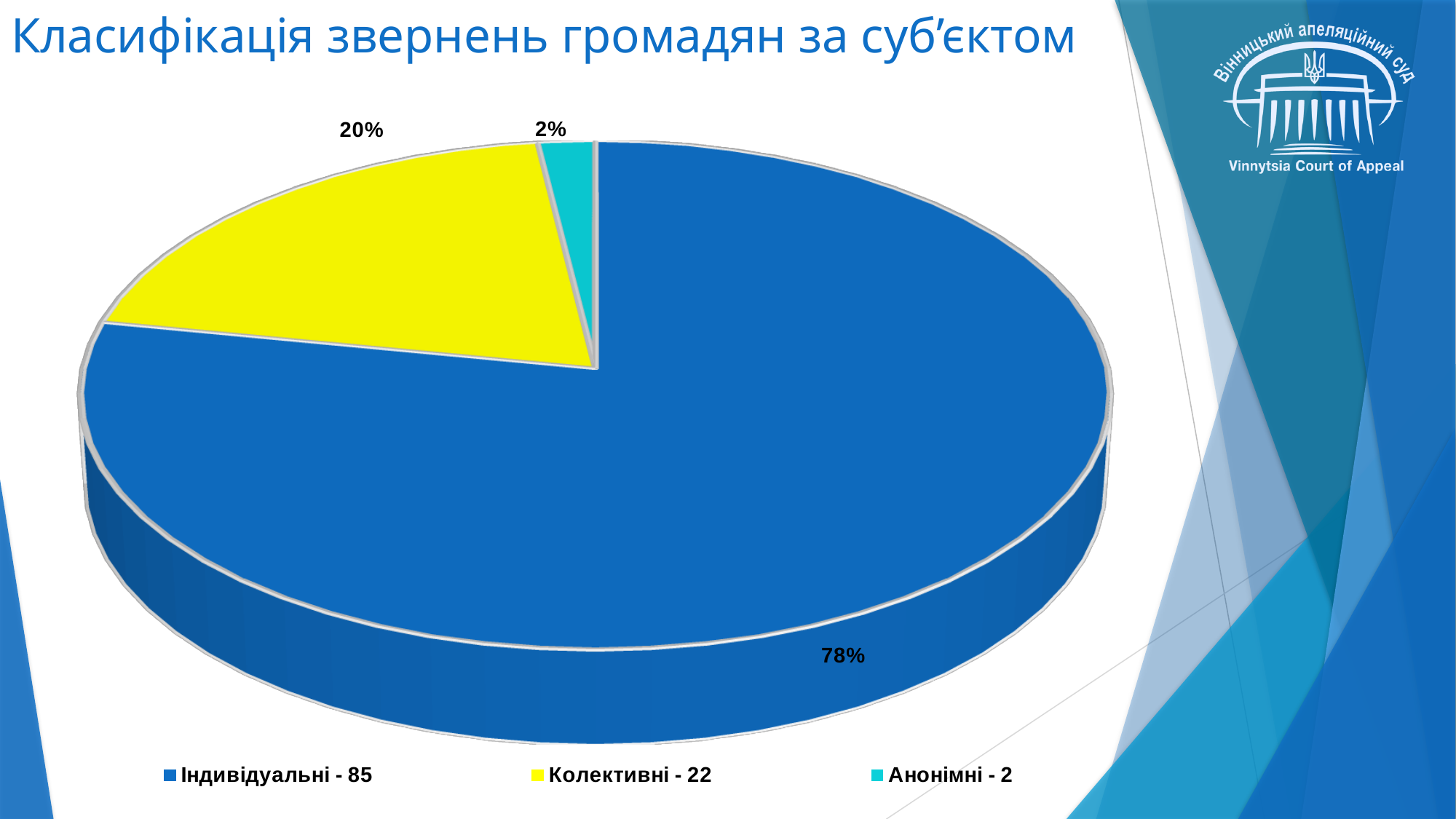
How many categories does the pie chart show? 3 What is the difference between the number of Індивідуальні and Колективні appeals shown in the legend? 63 According to the legend, how many appeals are Індивідуальні? 85 What percentage of the pie does the Колективні slice represent? 20% According to the legend, how many appeals are Колективні? 22 What type of chart is shown on the slide? Pie chart Which category has the largest slice of the pie? Індивідуальні What percentage of the pie does the Анонімні slice represent? 2% Which is larger, the Колективні slice or the Анонімні slice? Колективні Which category has the smallest slice of the pie? Анонімні According to the legend, how many appeals are Анонімні? 2 What percentage of the pie does the Індивідуальні slice represent? 78%